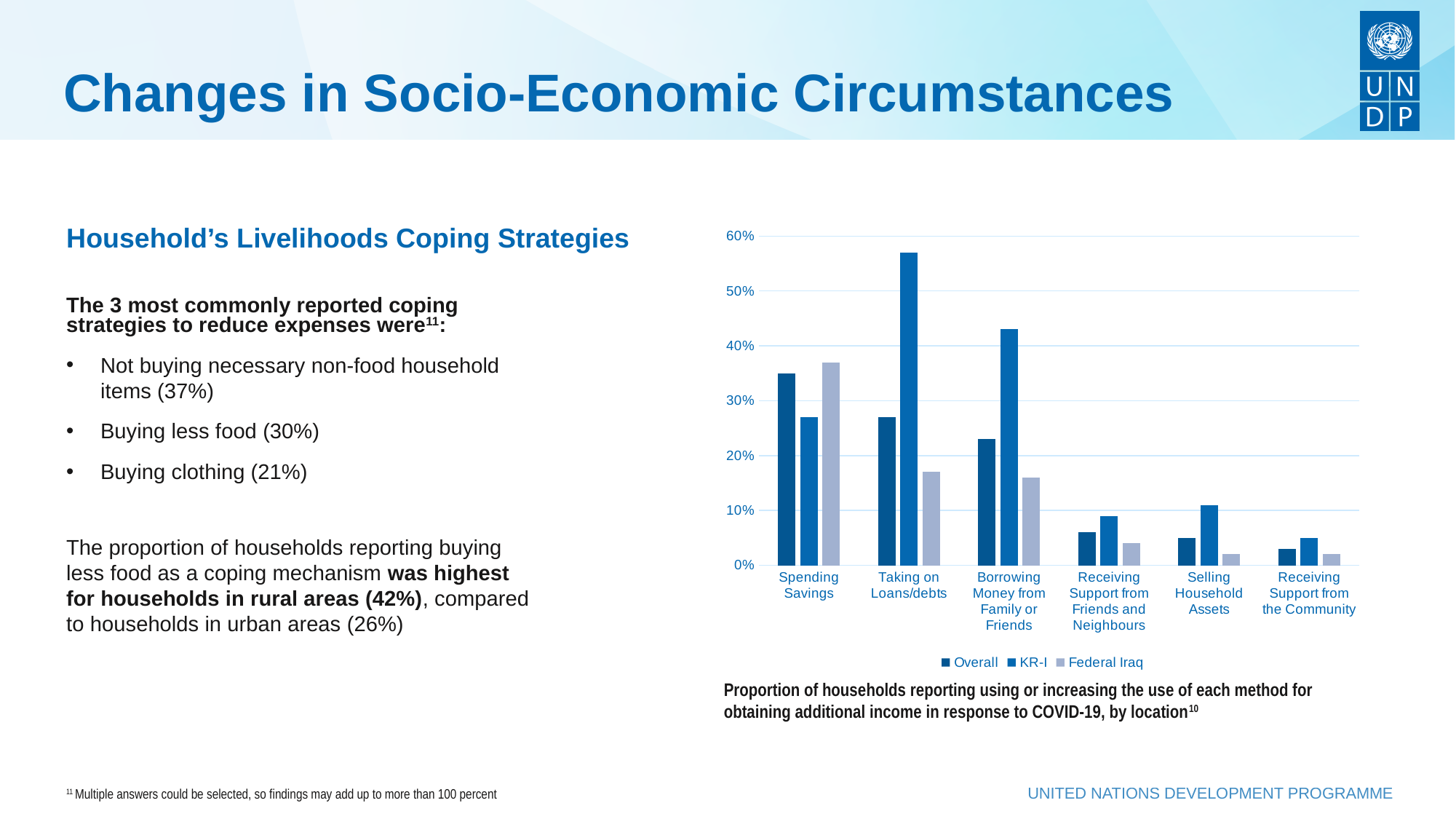
What kind of chart is shown on the slide? bar chart How many categories are shown on the x axis of the chart? 6 Is the KR-I value for Taking on Loans/debts greater or less than 50%? greater How many series does the chart's legend list? 3 Is the KR-I value for Borrowing Money from Family or Friends greater or less than 40%? greater For Spending Savings, which is larger: the Overall value or the KR-I value? Overall Is the Overall value for Spending Savings greater or less than 30%? greater For the KR-I series, which category has the highest value? Taking on Loans/debts For the Overall series, which category has the lowest value? Receiving Support from the Community Which series are listed in the chart's legend? Overall, KR-I, Federal Iraq For Borrowing Money from Family or Friends, which is larger: the KR-I value or the Federal Iraq value? KR-I